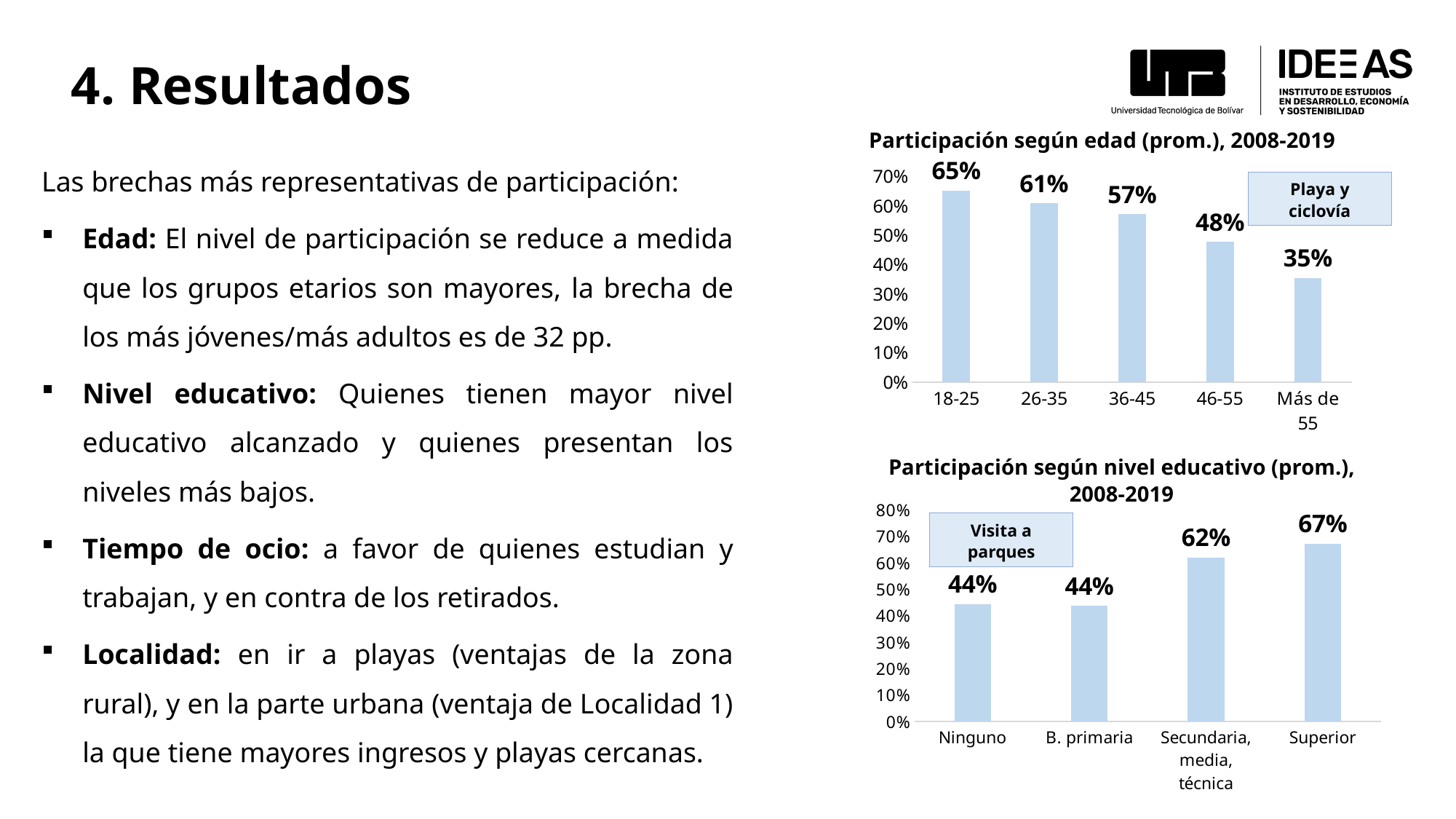
In the chart 'Participación según nivel educativo (prom.), 2008-2019', what is the value for Ninguno? 44% In the chart 'Participación según edad (prom.), 2008-2019', do the values rise or fall as age increases along the x axis? fall In the chart 'Participación según nivel educativo (prom.), 2008-2019', which is larger: Secundaria, media, técnica or Ninguno? Secundaria, media, técnica In the chart 'Participación según edad (prom.), 2008-2019', what is the value for the 18-25 age group? 65% What type of chart is 'Participación según nivel educativo (prom.), 2008-2019'? bar chart How many age groups are shown in the chart 'Participación según edad (prom.), 2008-2019'? 5 In the chart 'Participación según nivel educativo (prom.), 2008-2019', what is the value for Superior? 67% In the chart 'Participación según nivel educativo (prom.), 2008-2019', what is the difference between Superior and B. primaria? 23 pp In the chart 'Participación según edad (prom.), 2008-2019', what is the value for the 46-55 age group? 48% In the chart 'Participación según edad (prom.), 2008-2019', what is the difference between the 18-25 and Más de 55 groups? 30 pp In the chart 'Participación según nivel educativo (prom.), 2008-2019', which category has the highest participation? Superior In the chart 'Participación según edad (prom.), 2008-2019', which age group has the lowest participation? Más de 55